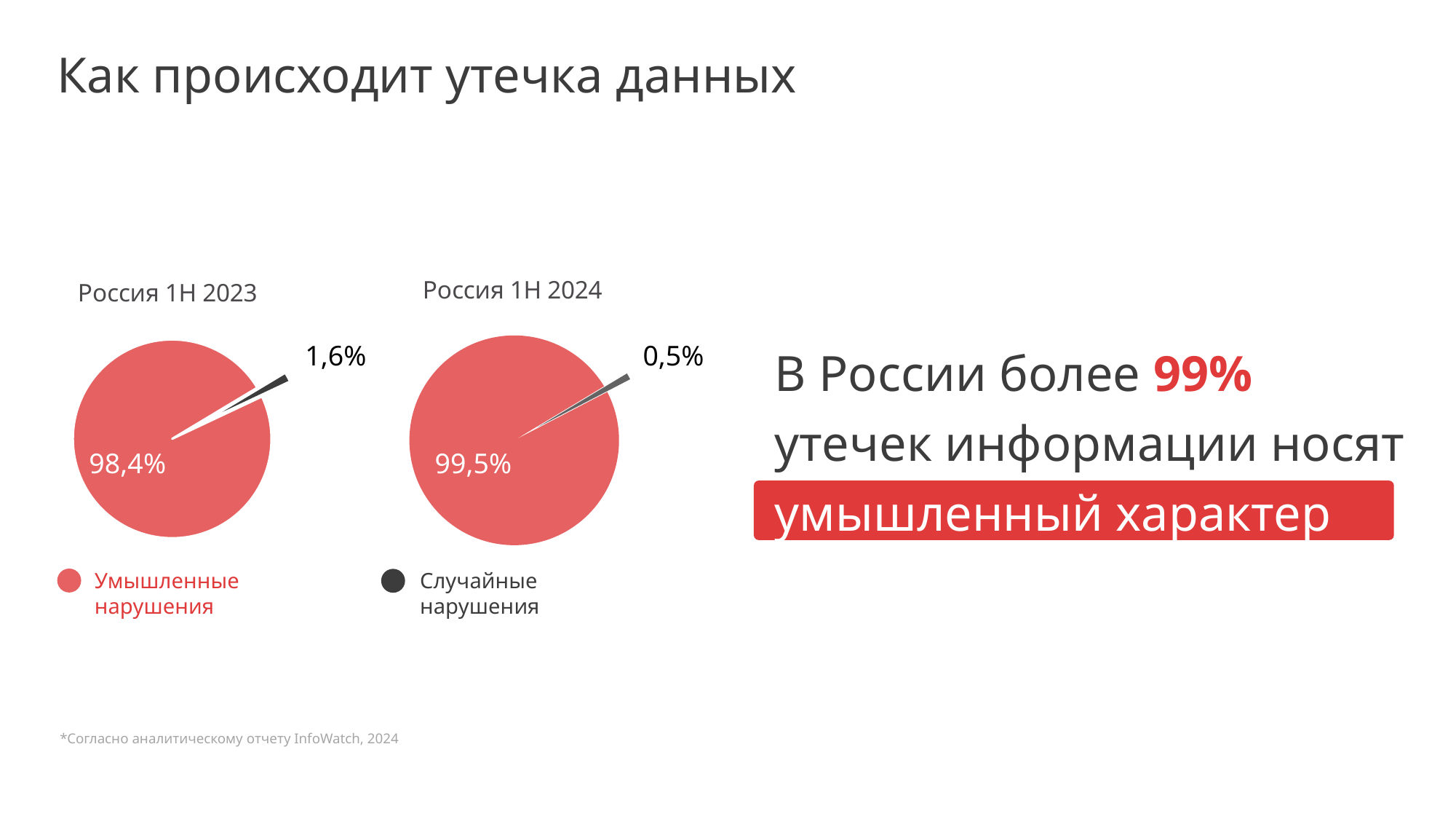
How many entries does the shared legend below the pie charts list? 2 In the "Россия 1H 2023" chart, what share is labelled for Случайные нарушения? 1,6% How many slices does the "Россия 1H 2024" chart have? 2 What is the difference between the share of Случайные нарушения in the "Россия 1H 2023" chart and in the "Россия 1H 2024" chart? 1,1% In the "Россия 1H 2023" chart, what share is labelled for Умышленные нарушения? 98,4% What colour represents Случайные нарушения in the pie charts? Dark grey In the "Россия 1H 2024" chart, which category has the smallest slice? Случайные нарушения In the "Россия 1H 2023" chart, which category has the largest slice? Умышленные нарушения What type of chart is "Россия 1H 2023"? Pie chart In the "Россия 1H 2024" chart, what share is labelled for Случайные нарушения? 0,5% Which is larger: the share of Случайные нарушения in the "Россия 1H 2023" chart or in the "Россия 1H 2024" chart? Россия 1H 2023 In the "Россия 1H 2024" chart, what share is labelled for Умышленные нарушения? 99,5%